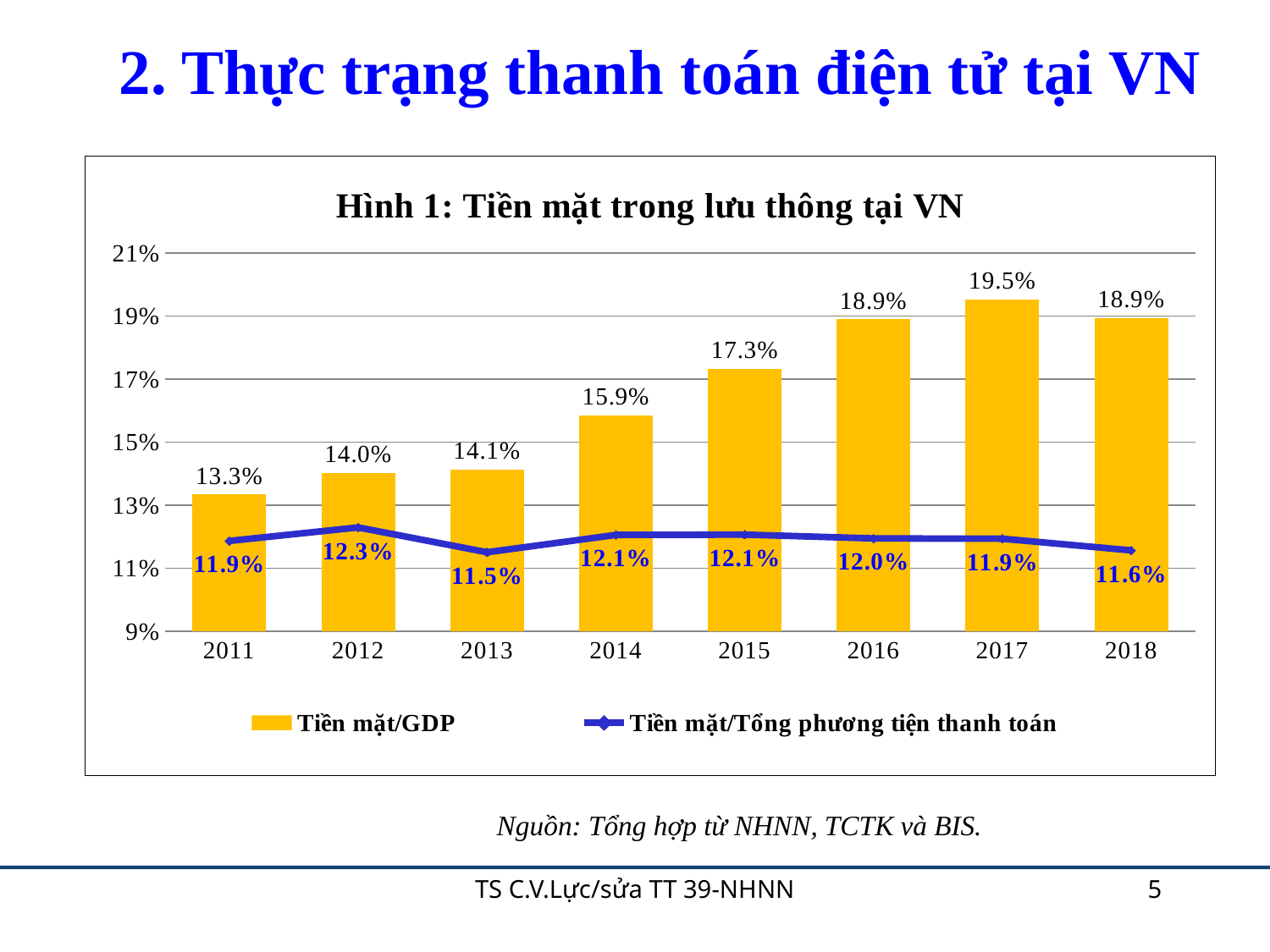
Which is larger, the Tiền mặt/GDP value for 2014 or for 2013? 2014 What is the value of Tiền mặt/GDP for 2015? 17.3% Is the Tiền mặt/GDP value for 2016 greater or less than 17%? greater What is the title of the chart? Hình 1: Tiền mặt trong lưu thông tại VN Which year has the highest Tiền mặt/GDP value? 2017 What is the difference between the Tiền mặt/GDP values for 2017 and 2011? 6.2% What is the value of Tiền mặt/Tổng phương tiện thanh toán for 2012? 12.3% How many series does the legend list? 2 How many years are shown on the x axis? 8 What is the value of Tiền mặt/GDP for 2011? 13.3% Which year has the lowest Tiền mặt/Tổng phương tiện thanh toán value? 2013 Does the Tiền mặt/GDP series generally rise or fall from 2011 to 2017? rise